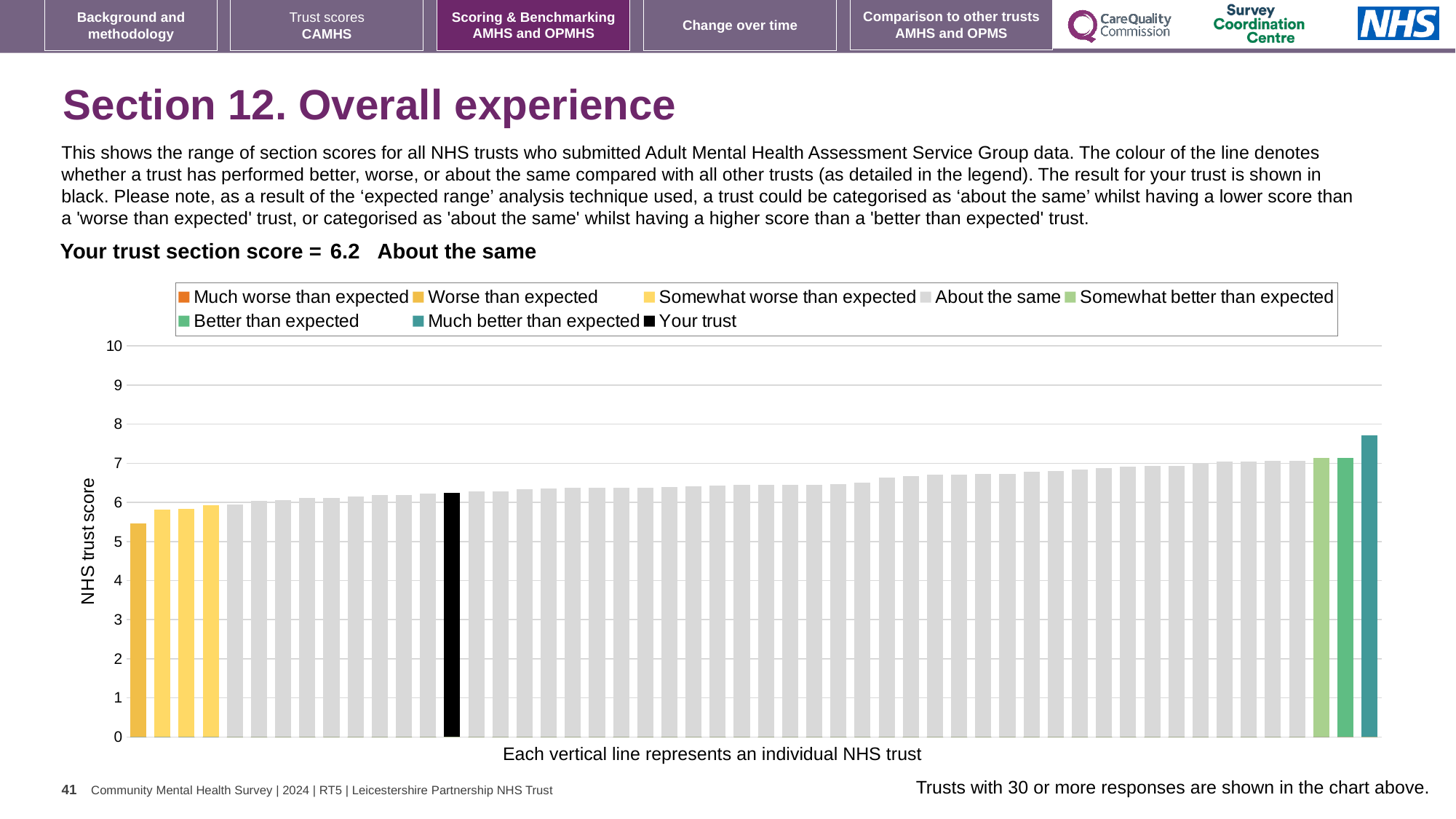
What is the label on the y axis of the chart? NHS trust score How many bars are coloured as 'Much better than expected'? 1 Is the value of the leftmost bar greater or less than 6? less Is the value of the tallest bar greater or less than 7? greater How many entries does the chart legend list? 8 Which legend category does the tallest bar belong to? Much better than expected Do the bar values rise or fall from left to right along the x axis? rise What colour is the bar representing your trust? black What is the section score for your trust shown on the slide? 6.2 Is the value for your trust greater or less than 5? greater What kind of chart is shown on the slide? bar chart Which category is your trust placed in for this section? About the same